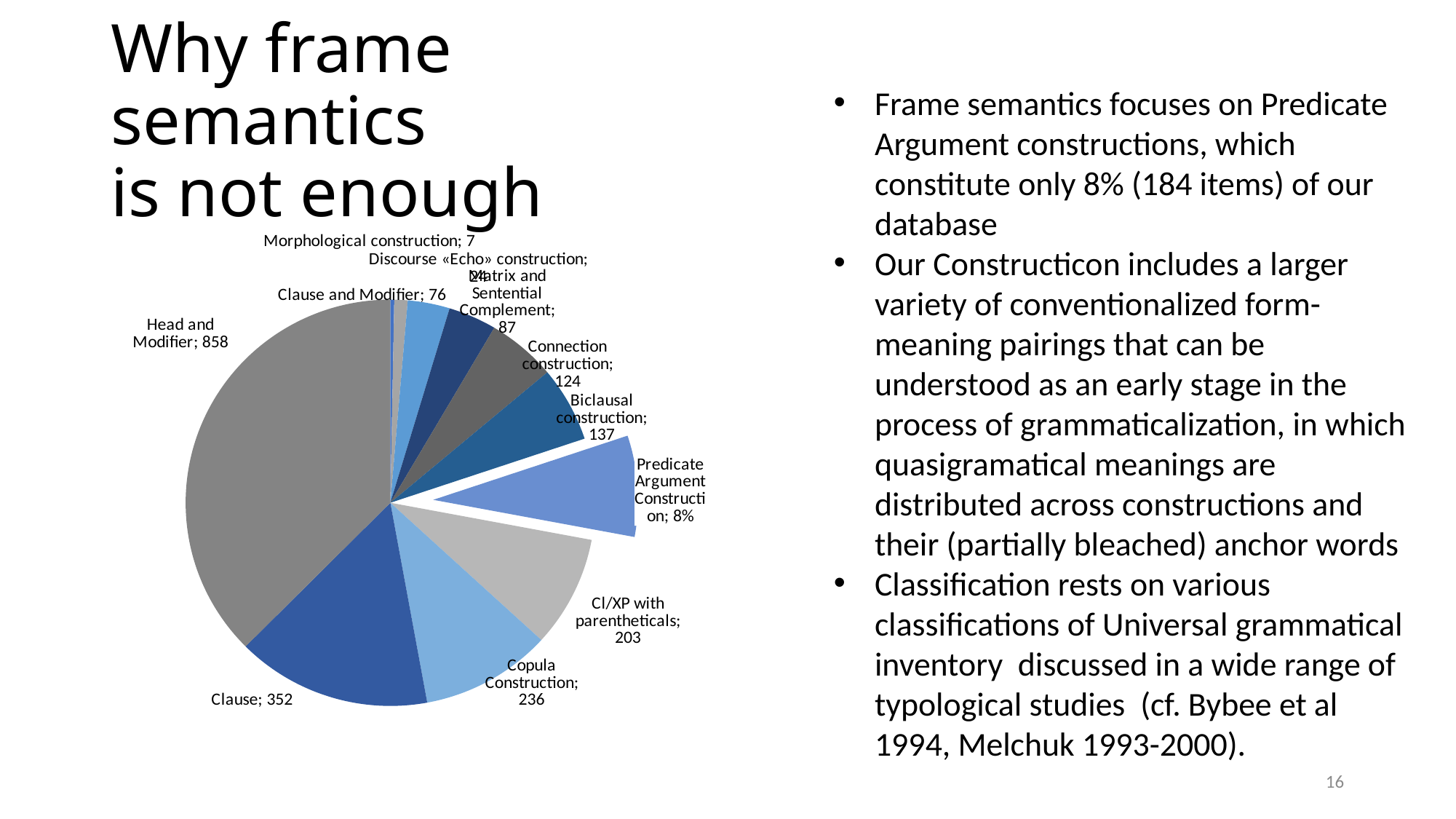
What is the value for Clause? 352 Which is larger, Connection construction or Matrix and Sentential Complement? Connection construction What is the value for Head and Modifier? 858 How many slices does the pie chart have? 11 What kind of chart is shown on the slide? pie chart Which category has the largest slice of the pie? Head and Modifier What is the value for Copula Construction? 236 What share of the pie is labelled for Predicate Argument Construction? 8% Which category has the smallest slice of the pie? Morphological construction What is the difference between the values for Clause and Copula Construction? 116 What is the value for Biclausal construction? 137 What is the value for Cl/XP with parentheticals? 203